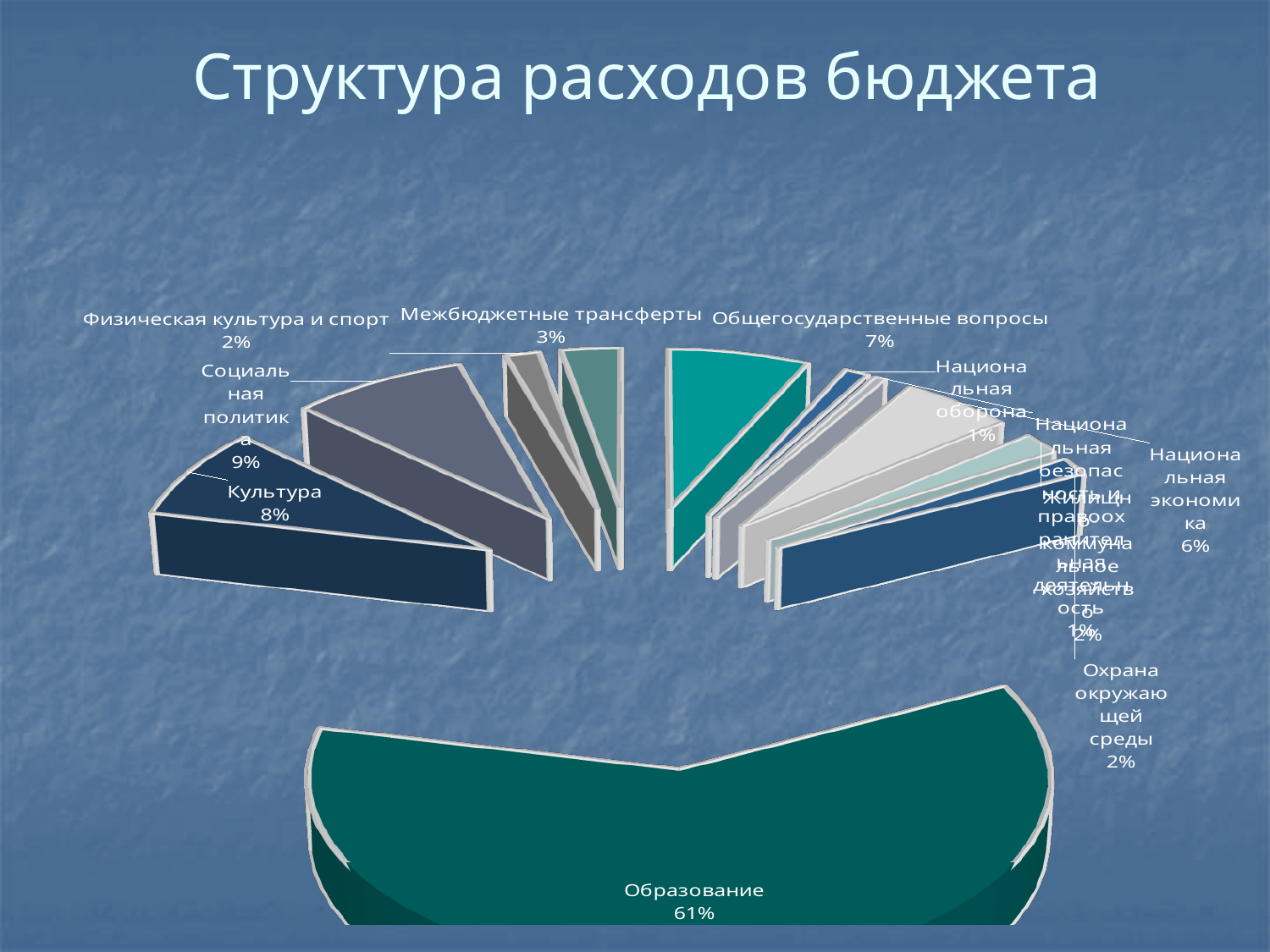
Which category has the largest share of the pie? Образование Which is larger, Социальная политика or Культура? Социальная политика What is the difference between the shares of Социальная политика and Культура? 1% What is the value shown for Социальная политика? 9% What is the value shown for Национальная оборона? 1% What share is shown for Национальная экономика? 6% What is the value for Общегосударственные вопросы? 7% What kind of chart is shown on the slide? Pie chart What percentage is labelled for Межбюджетные трансферты? 3% What is the title of the slide? Структура расходов бюджета What percentage is labelled for Культура? 8% What share of the pie does Образование account for? 61%